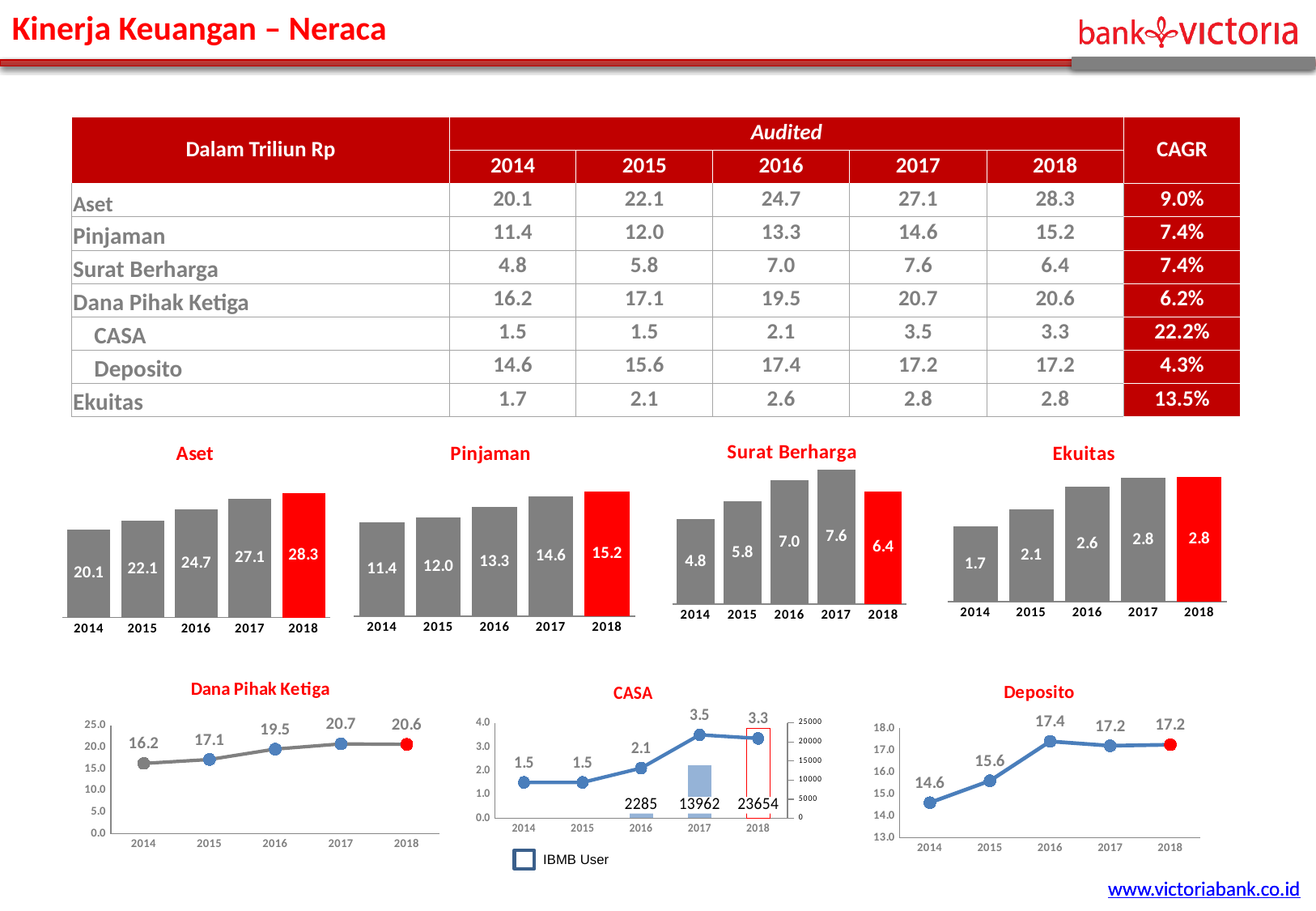
In the Ekuitas chart, what is the difference between the 2018 value and the 2014 value? 1.1 In the Pinjaman chart, what is the value for 2016? 13.3 In the Deposito chart, what is the value for 2015? 15.6 In the Aset chart, do the values rise or fall from 2014 to 2018? rise What kind of chart is the Pinjaman chart? bar chart In the Surat Berharga chart, which year has the lowest value? 2014 In the Surat Berharga chart, what is the difference between the 2017 value and the 2018 value? 1.2 In the CASA chart, what is the IBMB User value for 2018? 23654 How many years are plotted in the Aset chart? 5 In the Dana Pihak Ketiga chart, which is larger, the value for 2017 or the value for 2018? 2017 In the Surat Berharga chart, which year has the highest value? 2017 In the Aset chart, what is the value for 2018? 28.3